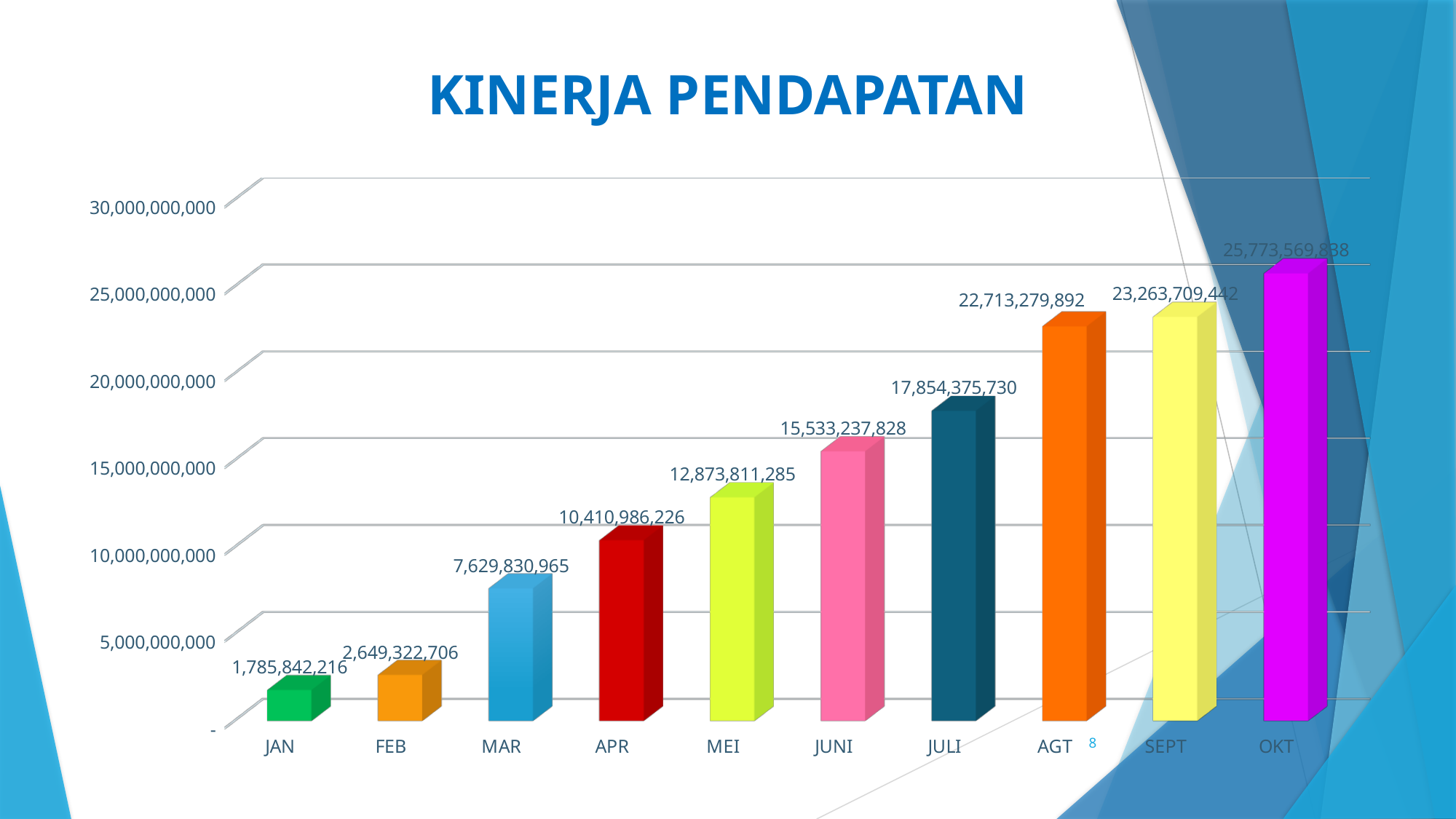
Which month has the highest value in the KINERJA PENDAPATAN chart? OKT What is the value for SEPT in the KINERJA PENDAPATAN chart? 23,263,709,442 What is the difference between the values for SEPT and AGT? 550,429,550 Do the values rise or fall from JAN to OKT? rise What is the difference between the values for FEB and JAN? 863,480,490 Which is larger, the value for MEI or the value for APR? MEI How many months are shown in the KINERJA PENDAPATAN chart? 10 What kind of chart is shown on the slide? bar chart What is the value for MAR in the KINERJA PENDAPATAN chart? 7,629,830,965 Which month has the lowest value in the KINERJA PENDAPATAN chart? JAN What is the value for JULI in the KINERJA PENDAPATAN chart? 17,854,375,730 Is the value for JULI greater or less than 20,000,000,000? less